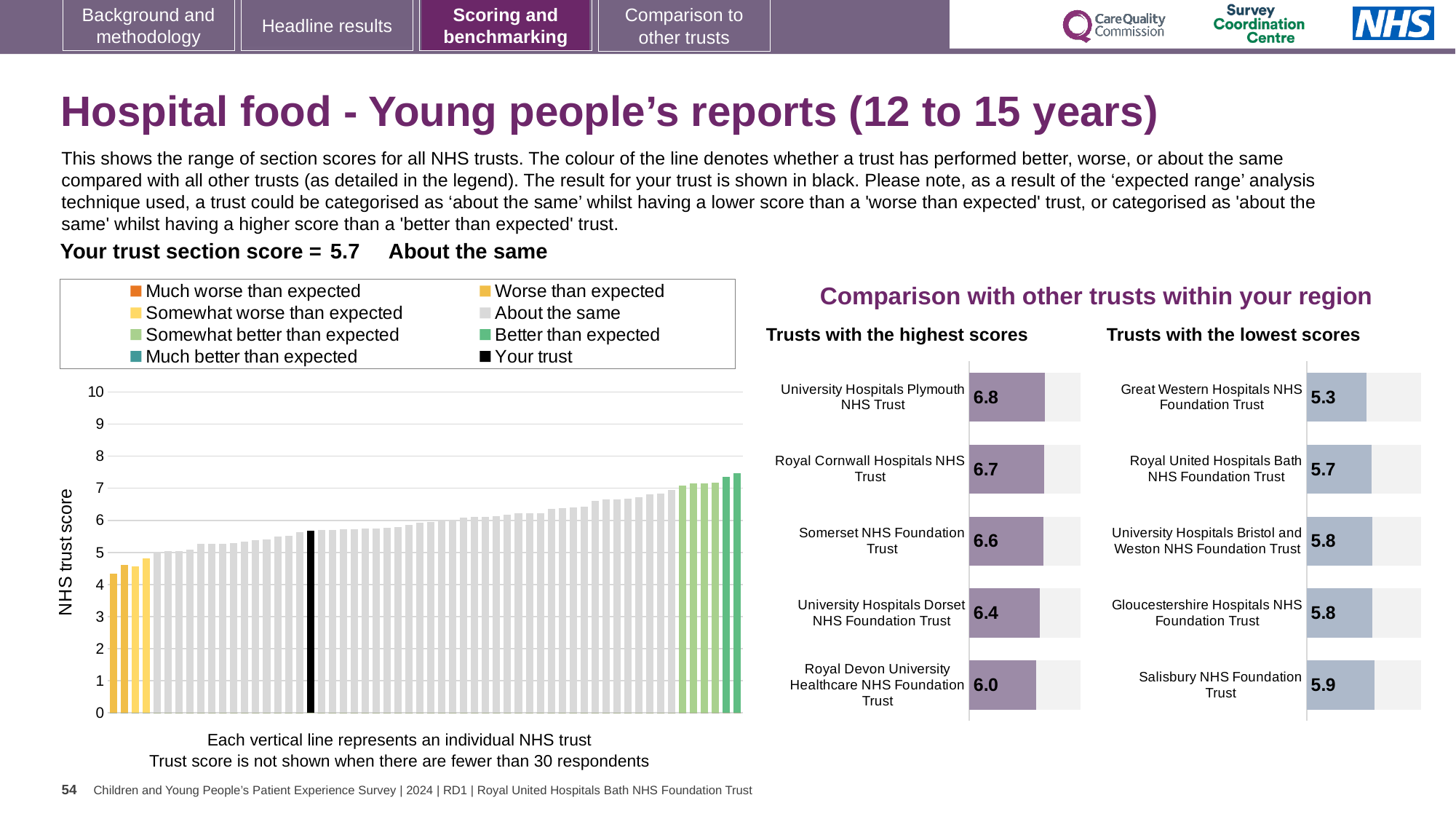
In the 'Trusts with the highest scores' chart, what is the difference between the scores of University Hospitals Plymouth NHS Trust and Royal Devon University Healthcare NHS Foundation Trust? 0.8 In the 'Trusts with the lowest scores' chart, what is the score for Salisbury NHS Foundation Trust? 5.9 In the 'Trusts with the lowest scores' chart, which trust has the highest score? Salisbury NHS Foundation Trust In the NHS trust score chart, do the bar values rise or fall from left to right? rise How many entries does the legend of the NHS trust score chart list? 8 In the 'Trusts with the lowest scores' chart, what is the score for Great Western Hospitals NHS Foundation Trust? 5.3 In the 'Trusts with the highest scores' chart, which trust has the lowest score? Royal Devon University Healthcare NHS Foundation Trust In the 'Trusts with the highest scores' chart, what is the score for University Hospitals Plymouth NHS Trust? 6.8 In the 'Trusts with the lowest scores' chart, which has the larger score: Royal United Hospitals Bath NHS Foundation Trust or Great Western Hospitals NHS Foundation Trust? Royal United Hospitals Bath NHS Foundation Trust In the NHS trust score chart, is the value for the black 'Your trust' bar greater or less than 5? greater In the 'Trusts with the highest scores' chart, what is the score for Somerset NHS Foundation Trust? 6.6 How many trusts are shown in the 'Trusts with the lowest scores' chart? 5